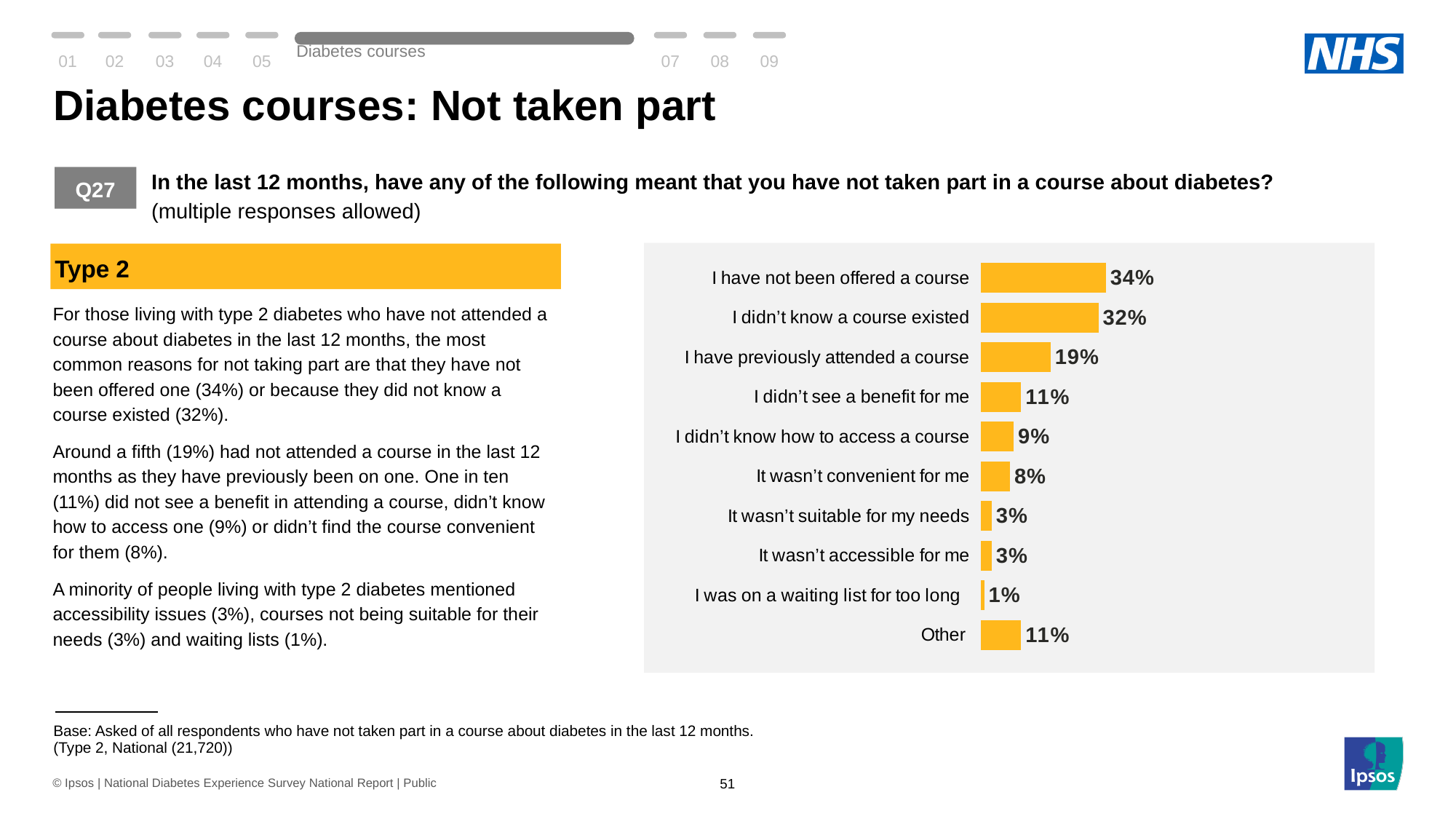
Which reason has the highest percentage in the chart? I have not been offered a course What type of chart is shown on the slide? Bar chart How many reasons (categories) are shown in the chart? 10 What percentage of respondents said they have previously attended a course? 19% Which reason has the lowest percentage in the chart? I was on a waiting list for too long What percentage of respondents said they have not been offered a course? 34% Which is larger: the value for 'I didn't see a benefit for me' or the value for 'It wasn't convenient for me'? I didn't see a benefit for me What is the difference in percentage points between 'I have not been offered a course' and 'I didn't know a course existed'? 2 percentage points What percentage of respondents said they were on a waiting list for too long? 1% What percentage of respondents said they didn't know how to access a course? 9% What colour are the bars in the chart? Yellow/orange What percentage of respondents said they didn't know a course existed? 32%